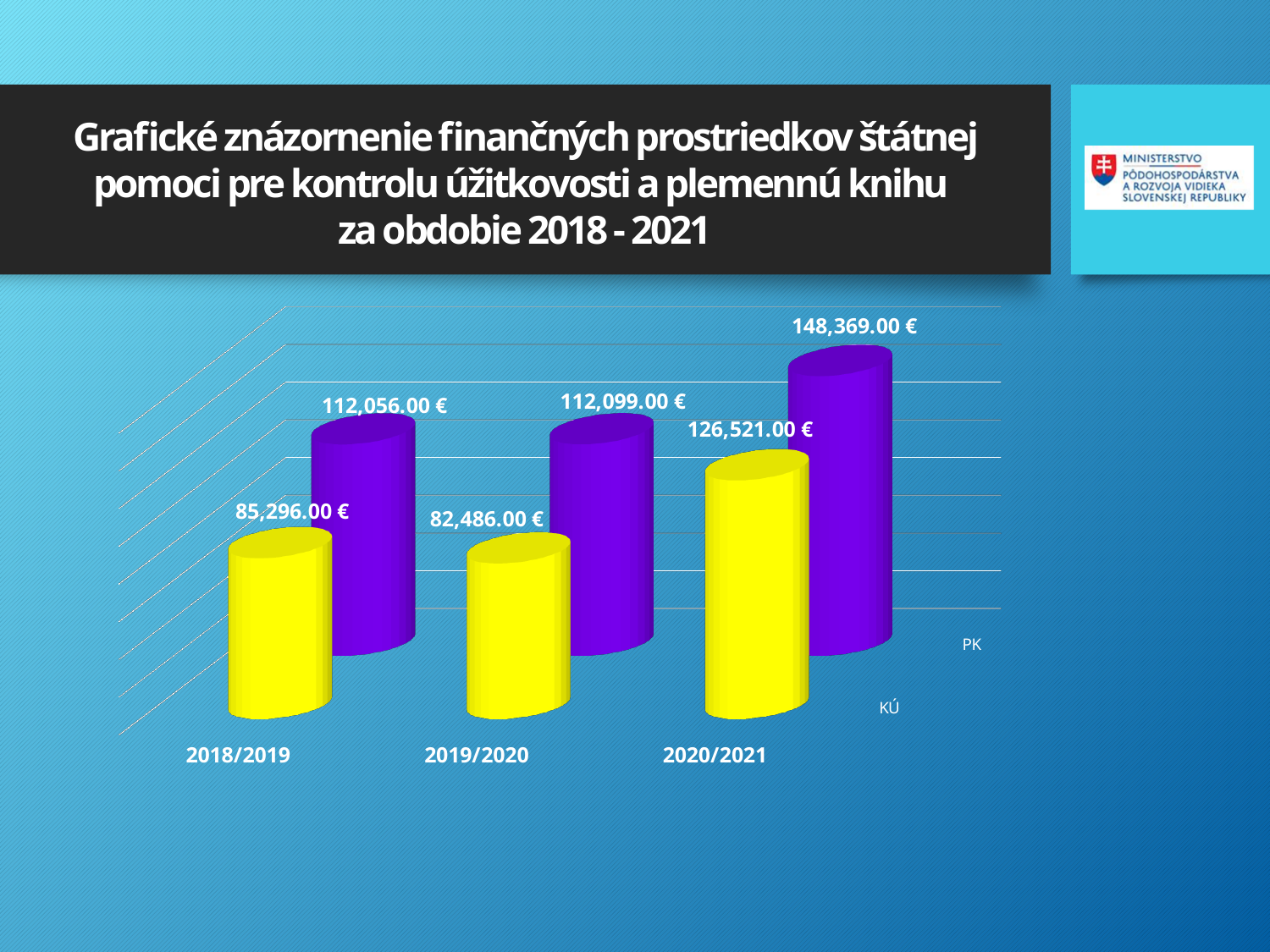
How many series does the chart show? 2 How many periods are shown on the x axis? 3 In which period is the KÚ value lowest? 2019/2020 What is the value for KÚ in 2019/2020? 82,486.00 € What kind of chart is shown on the slide? bar chart What is the value for PK in 2020/2021? 148,369.00 € In which period is the KÚ value highest? 2020/2021 What is the value for KÚ in 2018/2019? 85,296.00 € What is the difference between the PK and KÚ values in 2020/2021? 21,848.00 € Which is larger in 2019/2020, the PK value or the KÚ value? PK Which colour represents the PK series? purple What is the value for PK in 2018/2019? 112,056.00 €